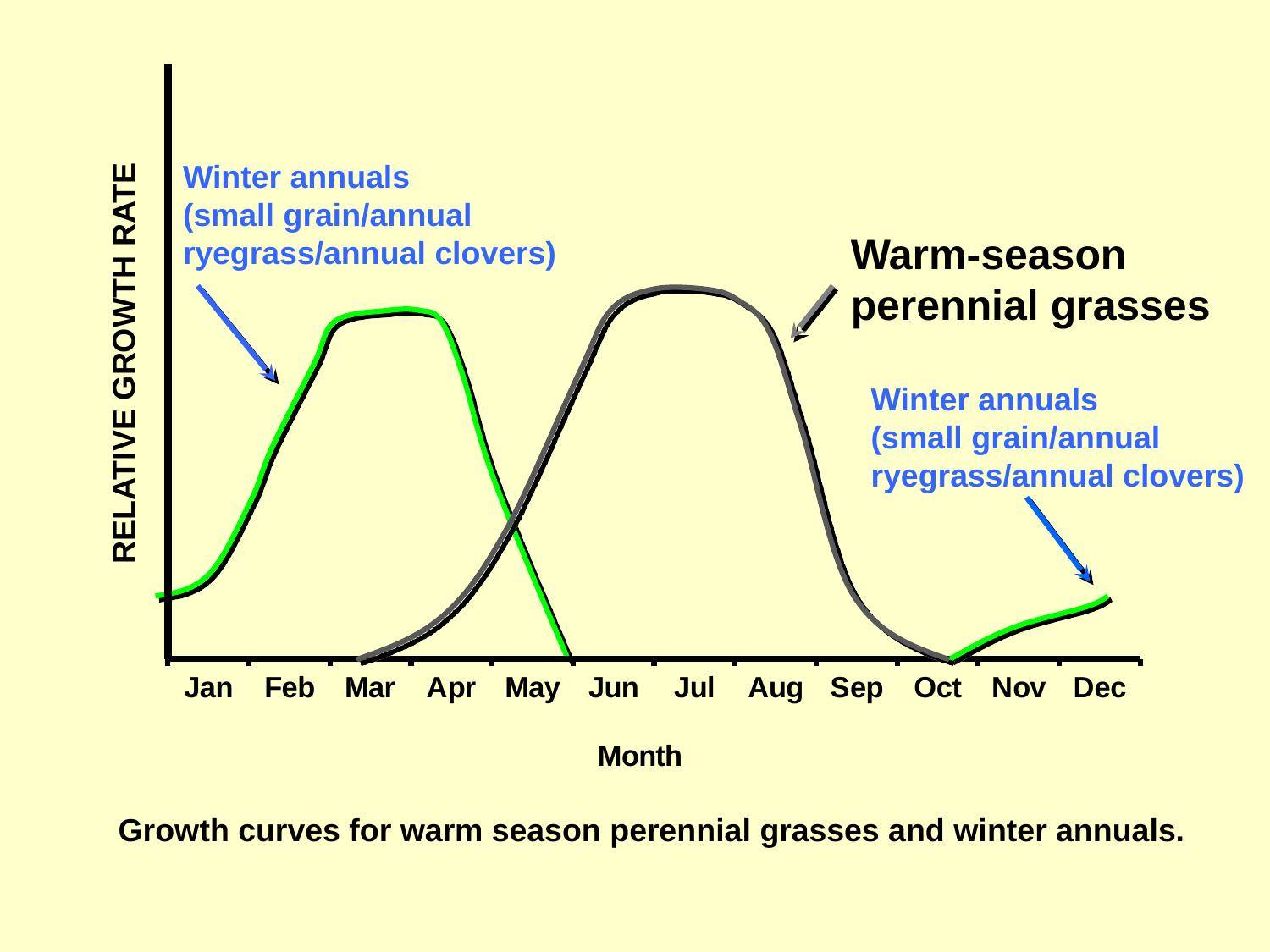
Which curve has the higher relative growth rate in Jul, winter annuals or warm-season perennial grasses? Warm-season perennial grasses Which curve has the higher relative growth rate in Feb, winter annuals or warm-season perennial grasses? Winter annuals Does the warm-season perennial grasses curve rise or fall from Aug to Oct? Fall What is the label on the y axis of the chart? RELATIVE GROWTH RATE What colour is the winter annuals curve? Green Does the winter annuals curve rise or fall from Apr to May? Fall How many months are labelled along the x axis? 12 Does the winter annuals curve rise or fall from Jan to Mar? Rise What kind of chart is shown on the slide? Line chart How many growth curves are plotted on the chart? 2 In which month does the warm-season perennial grasses curve reach its peak? Jul